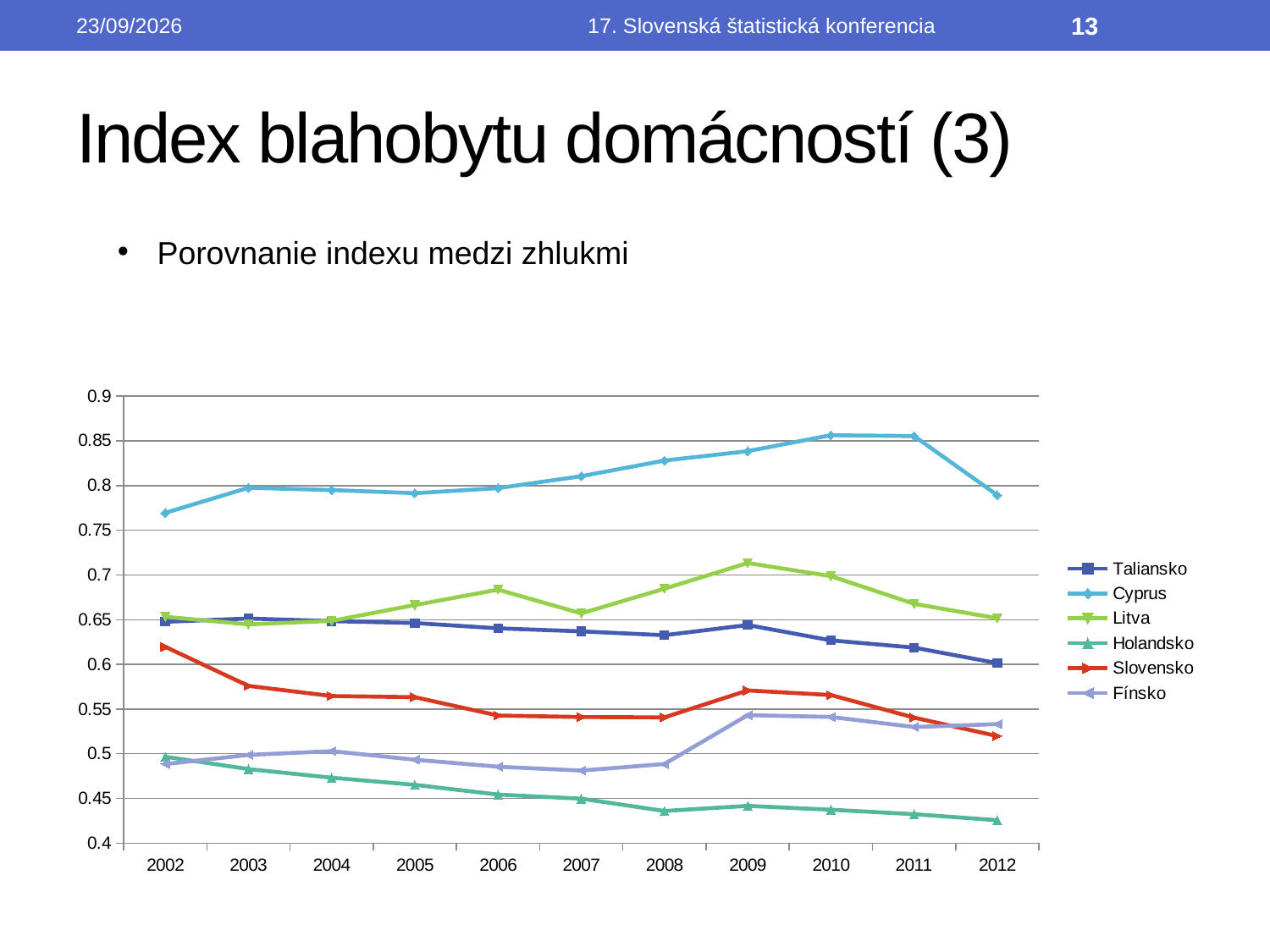
Which series is listed first in the legend? Taliansko What kind of chart is shown on the slide? line chart Which is larger in 2009, the value for Litva or the value for Taliansko? Litva Which series has the lowest value in 2012? Holandsko Which series has the highest value in 2010? Cyprus Is the value for Cyprus in 2010 greater or less than 0.85? greater How many years are shown on the x axis? 11 In which year does Litva reach its highest value? 2009 How many series does the legend list? 6 Is the value for Litva in 2009 greater or less than 0.7? greater Does the value for Holandsko rise or fall from 2002 to 2012? fall Is the value for Slovensko in 2012 greater or less than 0.55? less